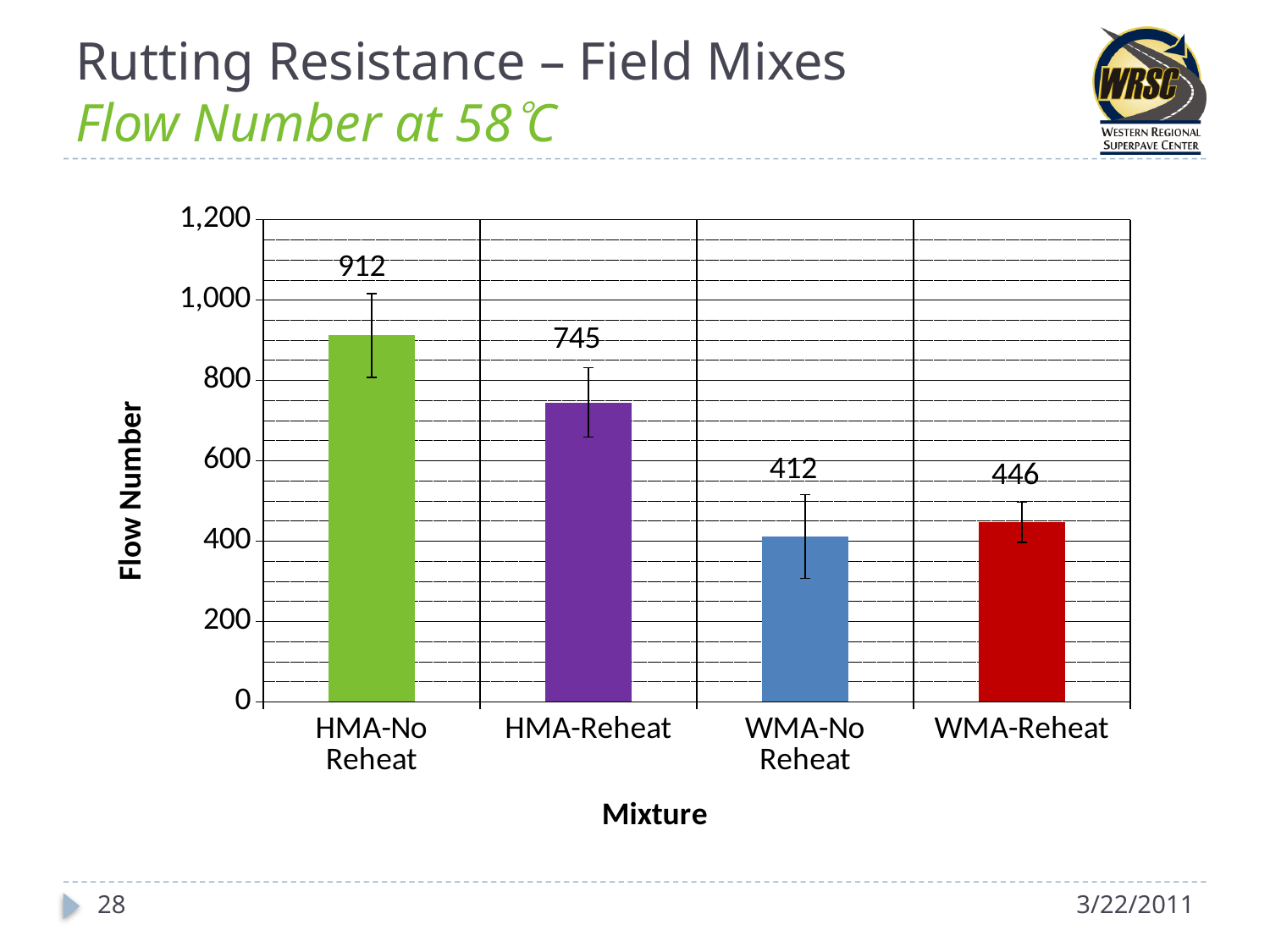
What is the flow number for HMA-Reheat? 745 How many mixtures are shown on the x axis? 4 Which mixture has the highest flow number? HMA-No Reheat What is the flow number for WMA-Reheat? 446 What is the difference in flow number between HMA-No Reheat and HMA-Reheat? 167 Is the flow number for WMA-No Reheat greater or less than 600? less What kind of chart is shown on the slide? bar chart What is the difference in flow number between WMA-Reheat and WMA-No Reheat? 34 Which has a larger flow number, HMA-Reheat or WMA-Reheat? HMA-Reheat What is the label of the y axis? Flow Number Which mixture has the lowest flow number? WMA-No Reheat What is the flow number for HMA-No Reheat? 912